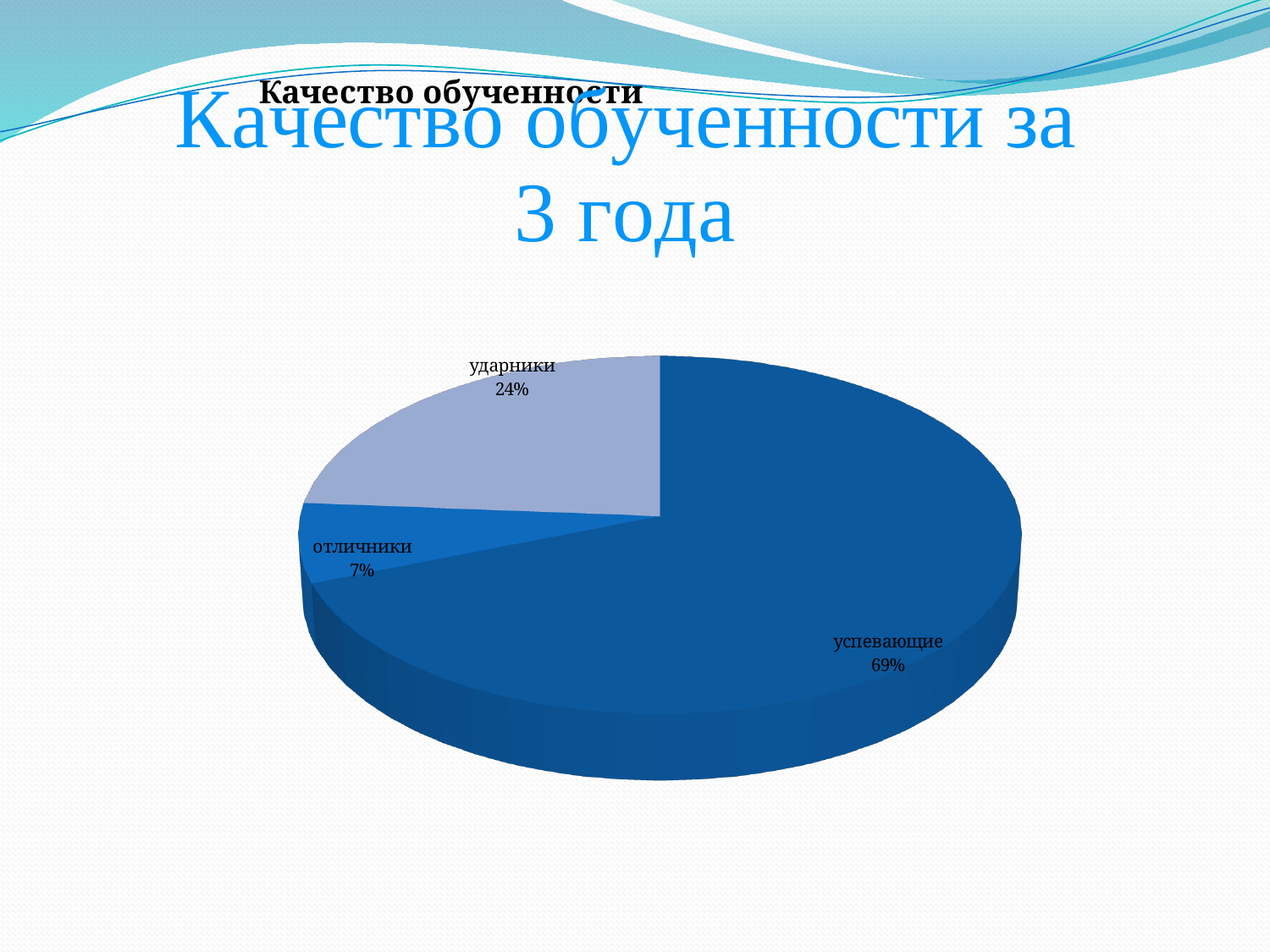
What is the combined share of the "ударники" and "отличники" slices? 31% What is the difference in percentage points between the "ударники" and "отличники" slices? 17 What share of the pie does the "отличники" slice represent? 7% How many slices does the pie chart have? 3 What share of the pie does the "успевающие" slice represent? 69% What is the difference in percentage points between the "успевающие" and "ударники" slices? 45 Which slice is larger, "ударники" or "отличники"? ударники What share of the pie does the "ударники" slice represent? 24% Which category has the smallest slice of the pie? отличники What kind of chart is shown on the slide? pie chart Which category has the largest slice of the pie? успевающие What is the title of the chart? Качество обученности